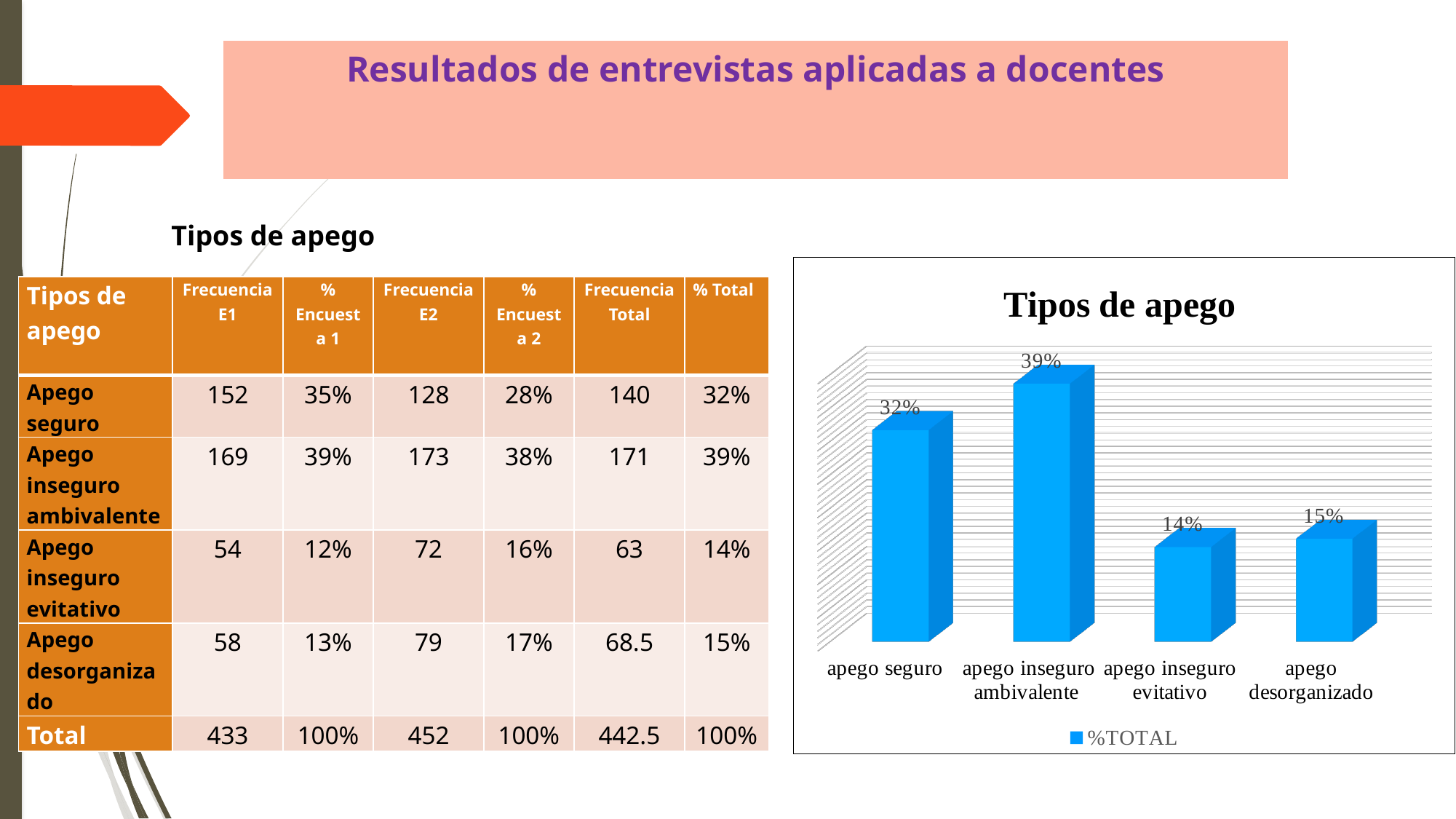
Which is larger, the value for apego seguro or the value for apego desorganizado? apego seguro What is the value for apego seguro in the chart? 32% How many series does the chart legend list? 1 What is the value for apego inseguro ambivalente in the chart? 39% What is the value for apego inseguro evitativo in the chart? 14% Which category has the highest value in the chart? apego inseguro ambivalente Which category has the lowest value in the chart? apego inseguro evitativo What is the value for apego desorganizado in the chart? 15% What is the title of the chart? Tipos de apego What kind of chart is shown on the slide? bar chart How many categories are shown in the chart? 4 What is the difference between the values for apego inseguro ambivalente and apego seguro? 7%